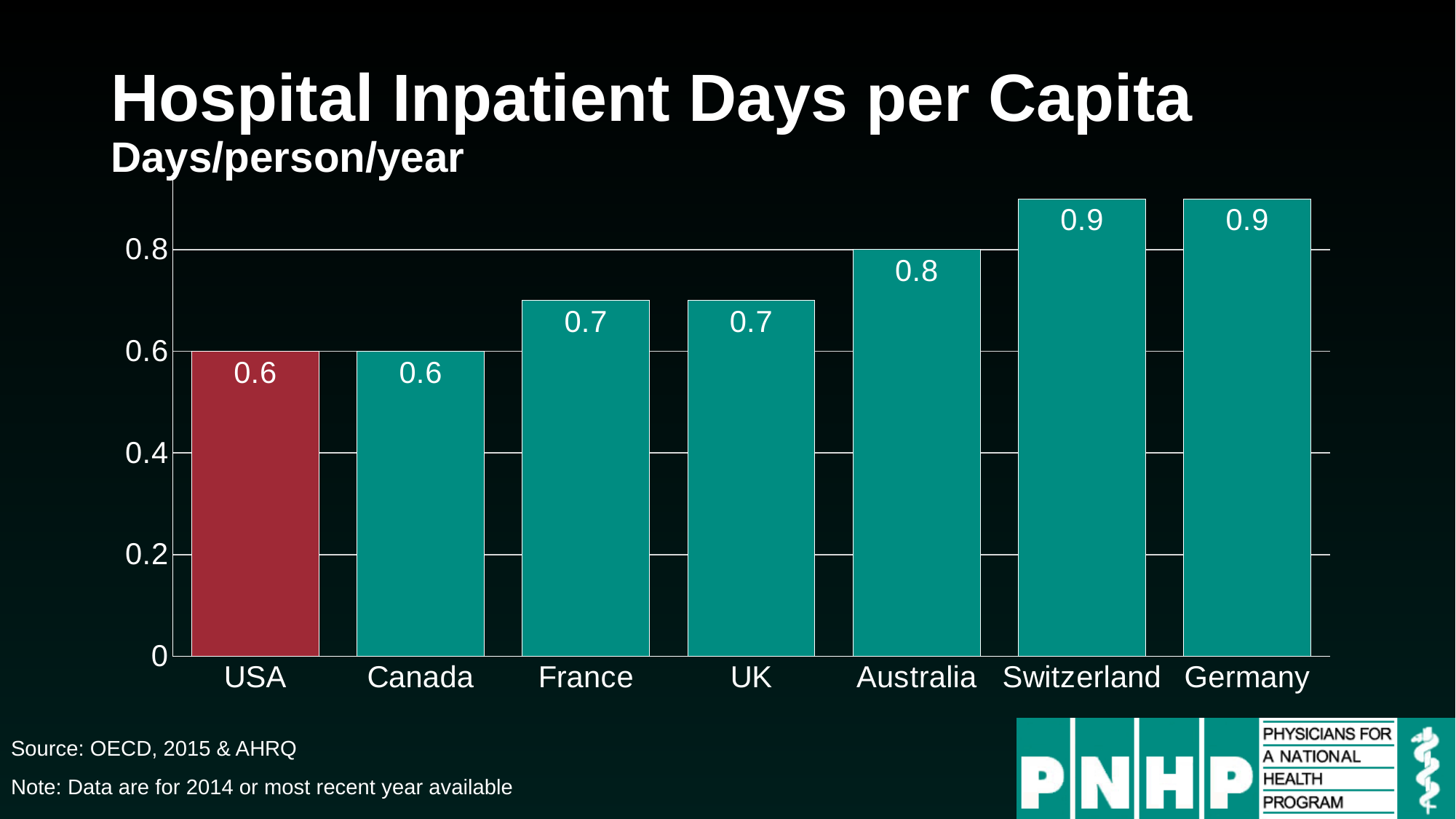
Which has a larger value, the UK or Germany? Germany Which country's bar is shown in a different colour (red) from the others? USA Which has a larger value, Canada or Australia? Australia What is the value for France? 0.7 What is the value for Australia? 0.8 What is the value for the USA? 0.6 What is the difference between the values for Australia and Canada? 0.2 What is the difference between the values for Germany and the USA? 0.3 What is the value for Switzerland? 0.9 Do the values generally rise or fall from left to right across the countries? Rise What kind of chart is shown on the slide? Bar chart How many countries are shown in the chart? 7